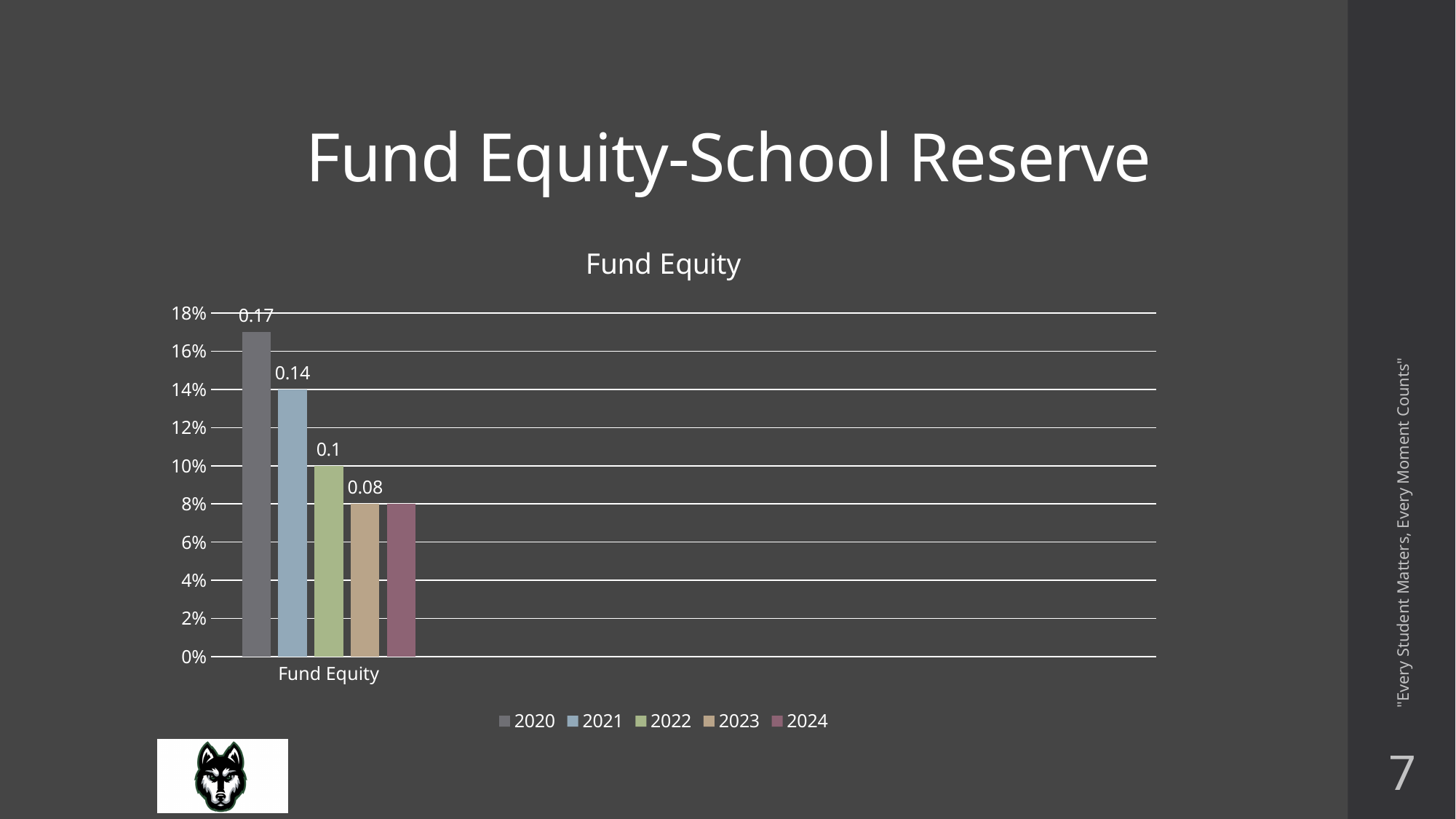
What kind of chart is shown on the slide? bar chart What is the value for 2022 in the Fund Equity chart? 0.1 Is the value for 2024 greater or less than 10%? less What is the difference between the 2021 and 2023 values? 0.06 How many series does the legend list? 5 Do the fund equity values rise or fall from 2020 to 2024? fall What is the difference between the 2020 and 2021 values? 0.03 What is the value for 2021 in the Fund Equity chart? 0.14 Which year has the highest fund equity value? 2020 What is the value for 2020 in the Fund Equity chart? 0.17 What is the value for 2023 in the Fund Equity chart? 0.08 Which is larger, the value for 2021 or the value for 2022? 2021